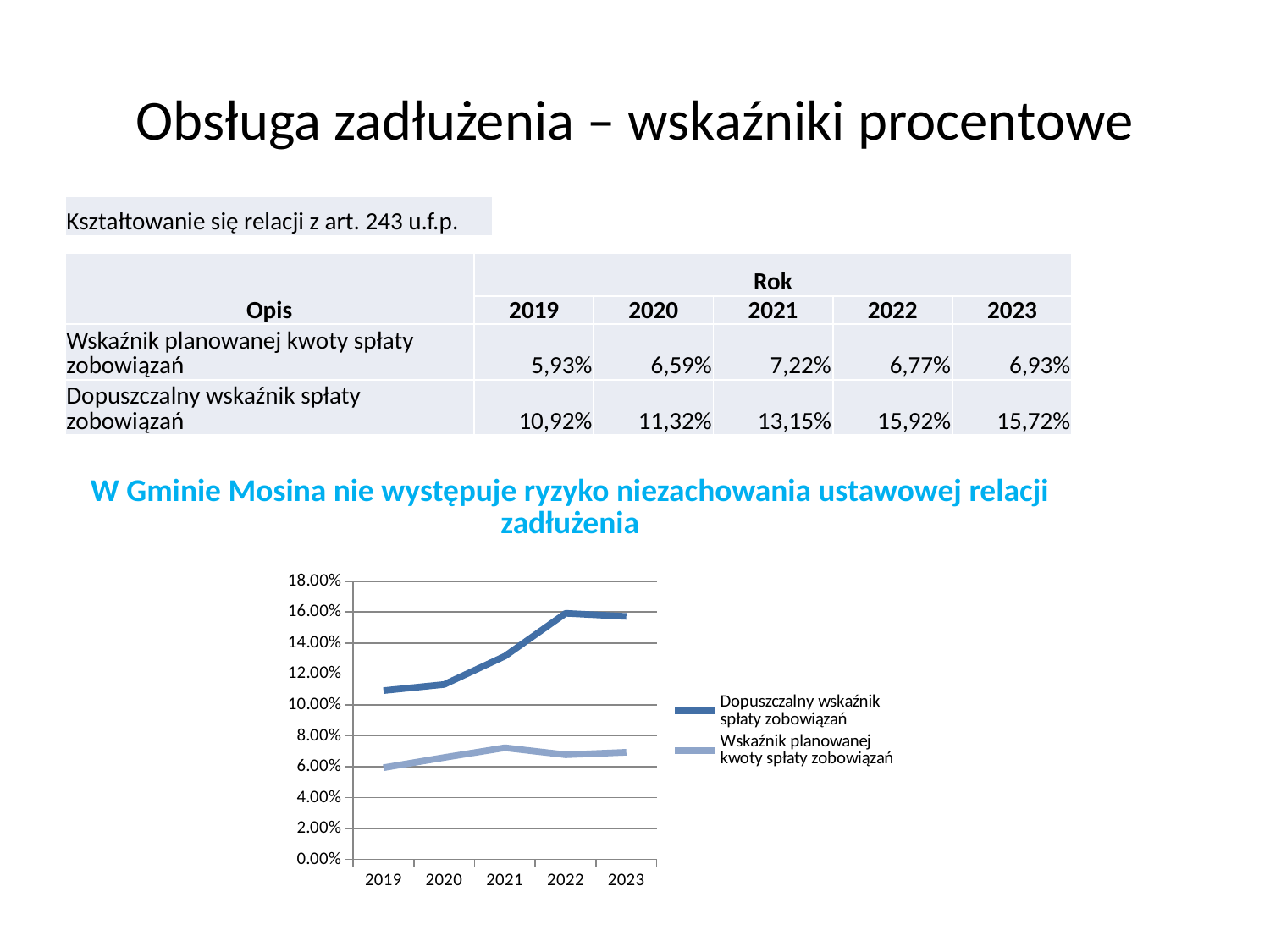
What is the difference between 'Dopuszczalny wskaźnik spłaty zobowiązań' and 'Wskaźnik planowanej kwoty spłaty zobowiązań' in 2022, using the values printed on the slide? 9,15% According to the slide, what is the value of 'Wskaźnik planowanej kwoty spłaty zobowiązań' for 2019? 5,93% In which year is 'Wskaźnik planowanej kwoty spłaty zobowiązań' highest? 2021 In which year is 'Dopuszczalny wskaźnik spłaty zobowiązań' lowest? 2019 Does 'Dopuszczalny wskaźnik spłaty zobowiązań' generally rise or fall from 2019 to 2022? rise What kind of chart is shown on the slide? line chart How many series does the chart legend list? 2 How many years are plotted along the x axis of the chart? 5 Is the value for 'Wskaźnik planowanej kwoty spłaty zobowiązań' in 2020 greater or less than 8.00%? less According to the slide, what is the value of 'Dopuszczalny wskaźnik spłaty zobowiązań' for 2022? 15,92% Is the value for 'Dopuszczalny wskaźnik spłaty zobowiązań' in 2021 greater or less than 12.00%? greater Which series is higher in 2023, 'Dopuszczalny wskaźnik spłaty zobowiązań' or 'Wskaźnik planowanej kwoty spłaty zobowiązań'? Dopuszczalny wskaźnik spłaty zobowiązań